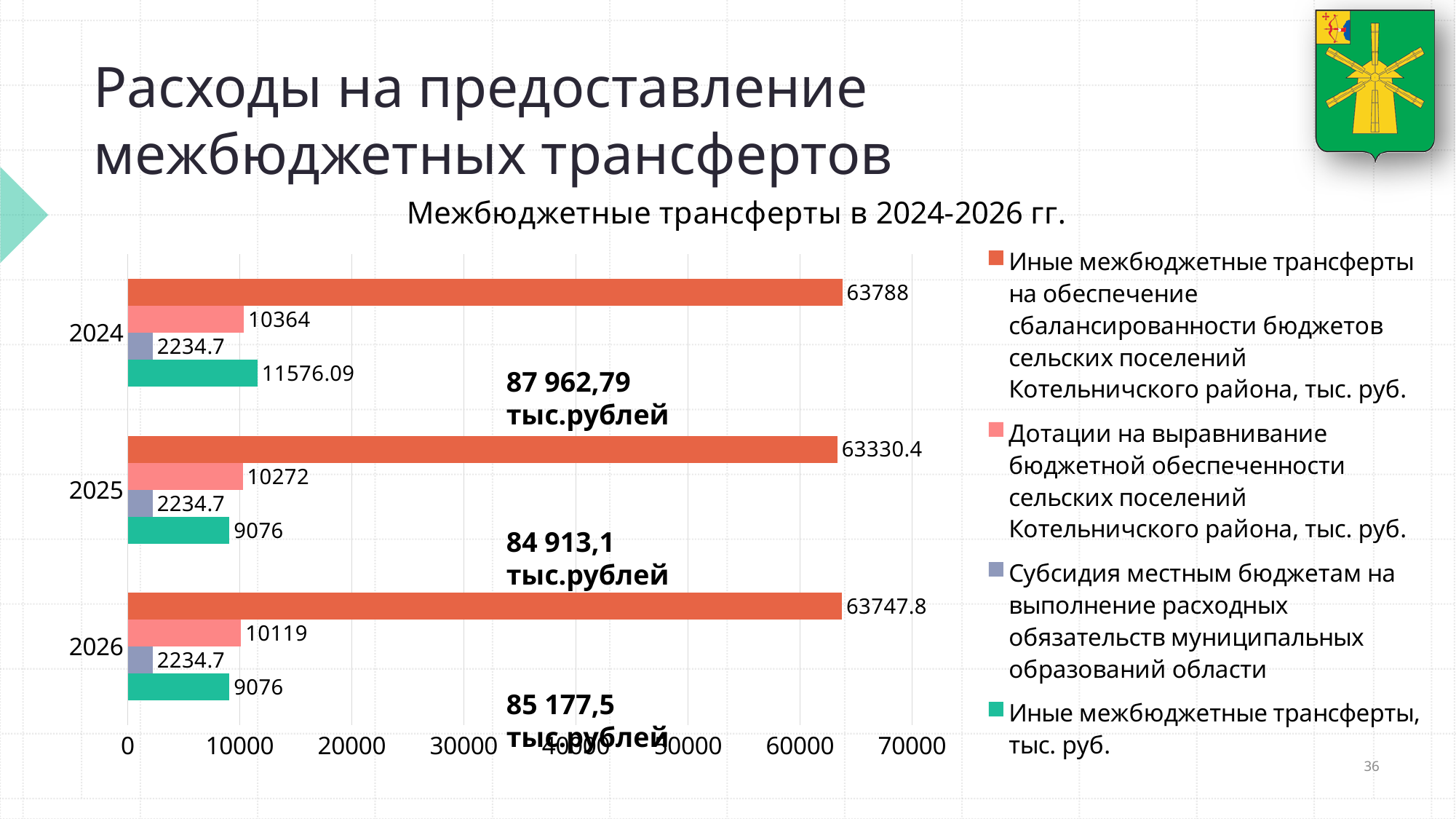
In which year is the value of 'Иные межбюджетные трансферты, тыс. руб.' the highest? 2024 Which is larger in 2026: 'Дотации на выравнивание бюджетной обеспеченности' or 'Иные межбюджетные трансферты, тыс. руб.'? Дотации на выравнивание бюджетной обеспеченности What is the title of the chart? Межбюджетные трансферты в 2024-2026 гг. What is the value of 'Дотации на выравнивание бюджетной обеспеченности сельских поселений Котельничского района' for 2024? 10364 What is the value of 'Иные межбюджетные трансферты на обеспечение сбалансированности бюджетов сельских поселений Котельничского района' for 2025? 63330.4 What is the difference between the 2024 and 2025 values of 'Дотации на выравнивание бюджетной обеспеченности сельских поселений Котельничского района'? 92 How many series does the legend list? 4 How many year categories are shown on the chart? 3 What total is annotated for 2025 on the chart? 84 913,1 тыс.рублей What is the value of 'Иные межбюджетные трансферты, тыс. руб.' for 2026? 9076 What is the value of 'Субсидия местным бюджетам на выполнение расходных обязательств муниципальных образований области' for 2024? 2234.7 What type of chart is shown on the slide? Bar chart